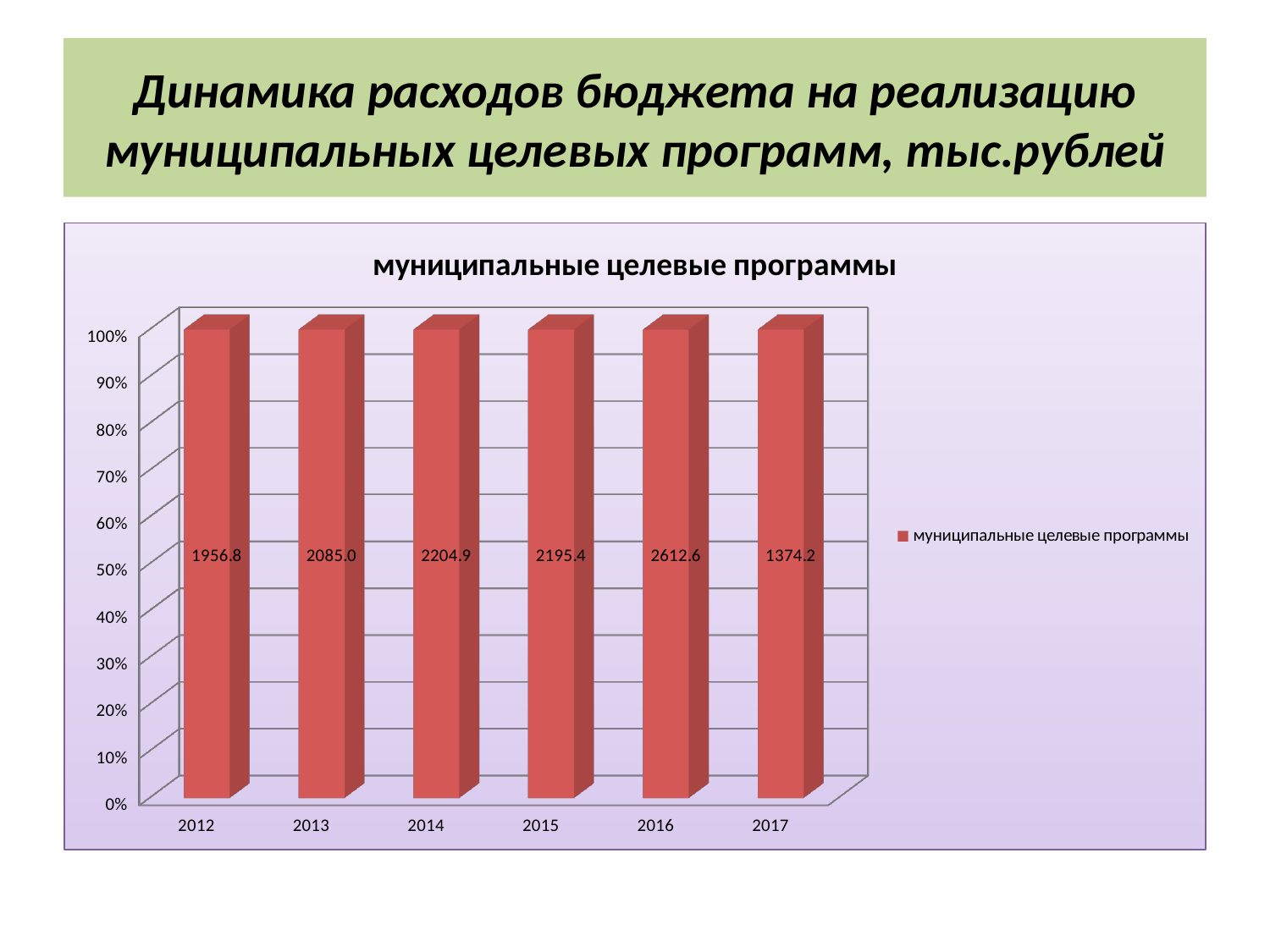
What is the data label for 2016? 2612.6 Which has the larger labelled value, 2014 or 2015? 2014 What is the data label for 2014? 2204.9 Which year has the lowest labelled value? 2017 What kind of chart is shown? bar chart How many series does the legend list? 1 How many years are shown on the x axis? 6 What is the data label for 2017? 1374.2 Which year has the highest labelled value? 2016 What is the difference between the labelled values for 2016 and 2017? 1238.4 What is the data label for 2012? 1956.8 What is the difference between the labelled values for 2013 and 2012? 128.2